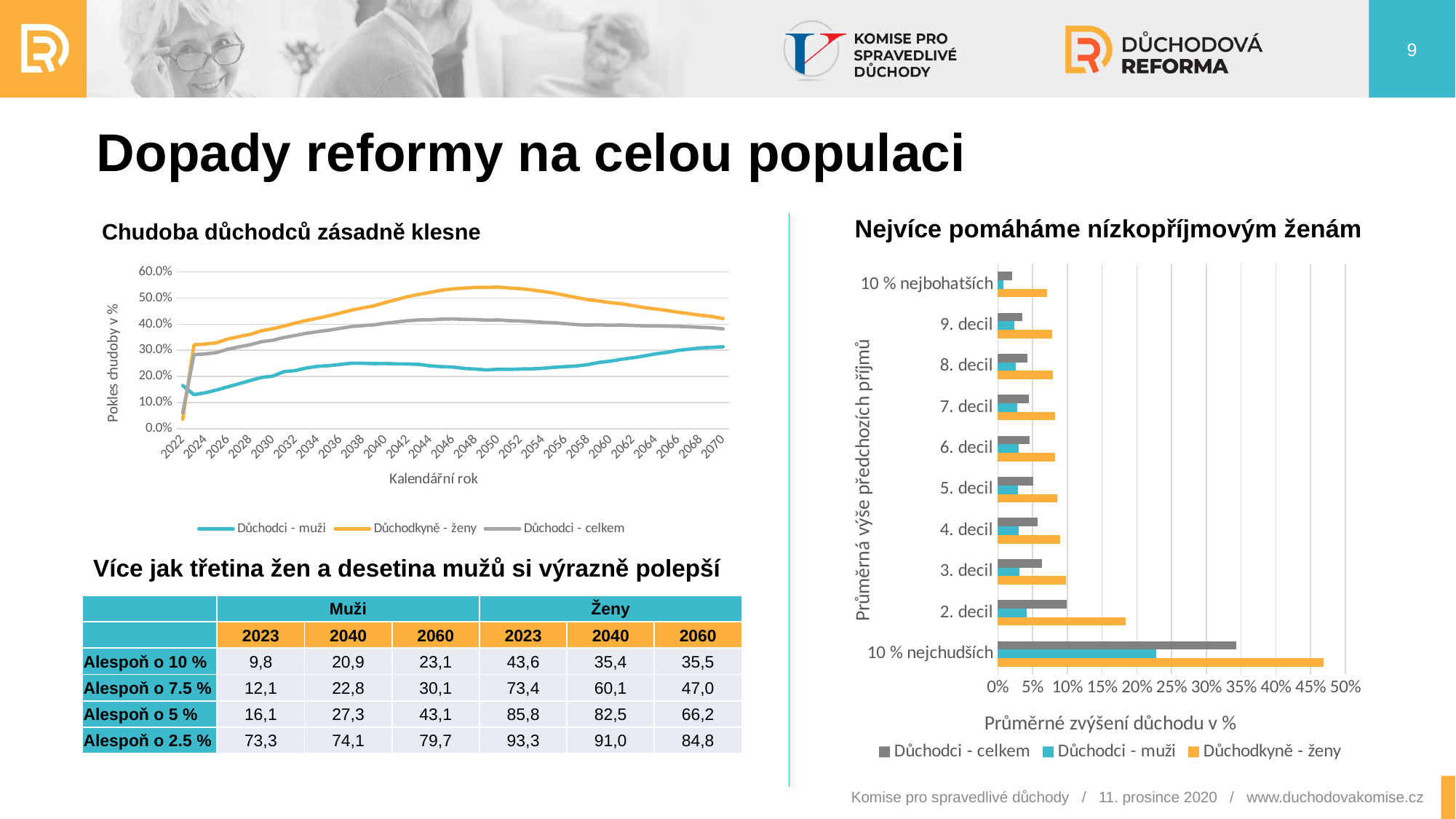
In the chart "Nejvíce pomáháme nízkopříjmovým ženám", which is larger for the category 10 % nejchudších: Důchodci - muži or Důchodkyně - ženy? Důchodkyně - ženy In the chart "Nejvíce pomáháme nízkopříjmovým ženám", do the values for Důchodkyně - ženy generally rise or fall when moving from 10 % nejbohatších down to 10 % nejchudších? rise In the chart "Nejvíce pomáháme nízkopříjmovým ženám", is the value for Důchodkyně - ženy in the category 10 % nejchudších greater or less than 40%? greater In the chart "Chudoba důchodců zásadně klesne", is the value for Důchodci - muži in 2050 greater or less than 30%? less What kind of chart is the chart titled "Chudoba důchodců zásadně klesne"? line chart What kind of chart is the chart titled "Nejvíce pomáháme nízkopříjmovým ženám"? bar chart In the chart "Chudoba důchodců zásadně klesne", is the value for Důchodkyně - ženy in 2050 greater or less than 50%? greater How many series does the legend of the chart "Chudoba důchodců zásadně klesne" list? 3 What is the x-axis title of the chart "Chudoba důchodců zásadně klesne"? Kalendářní rok In the chart "Nejvíce pomáháme nízkopříjmovým ženám", which category has the highest value for Důchodkyně - ženy? 10 % nejchudších How many categories are shown on the vertical axis of the chart "Nejvíce pomáháme nízkopříjmovým ženám"? 10